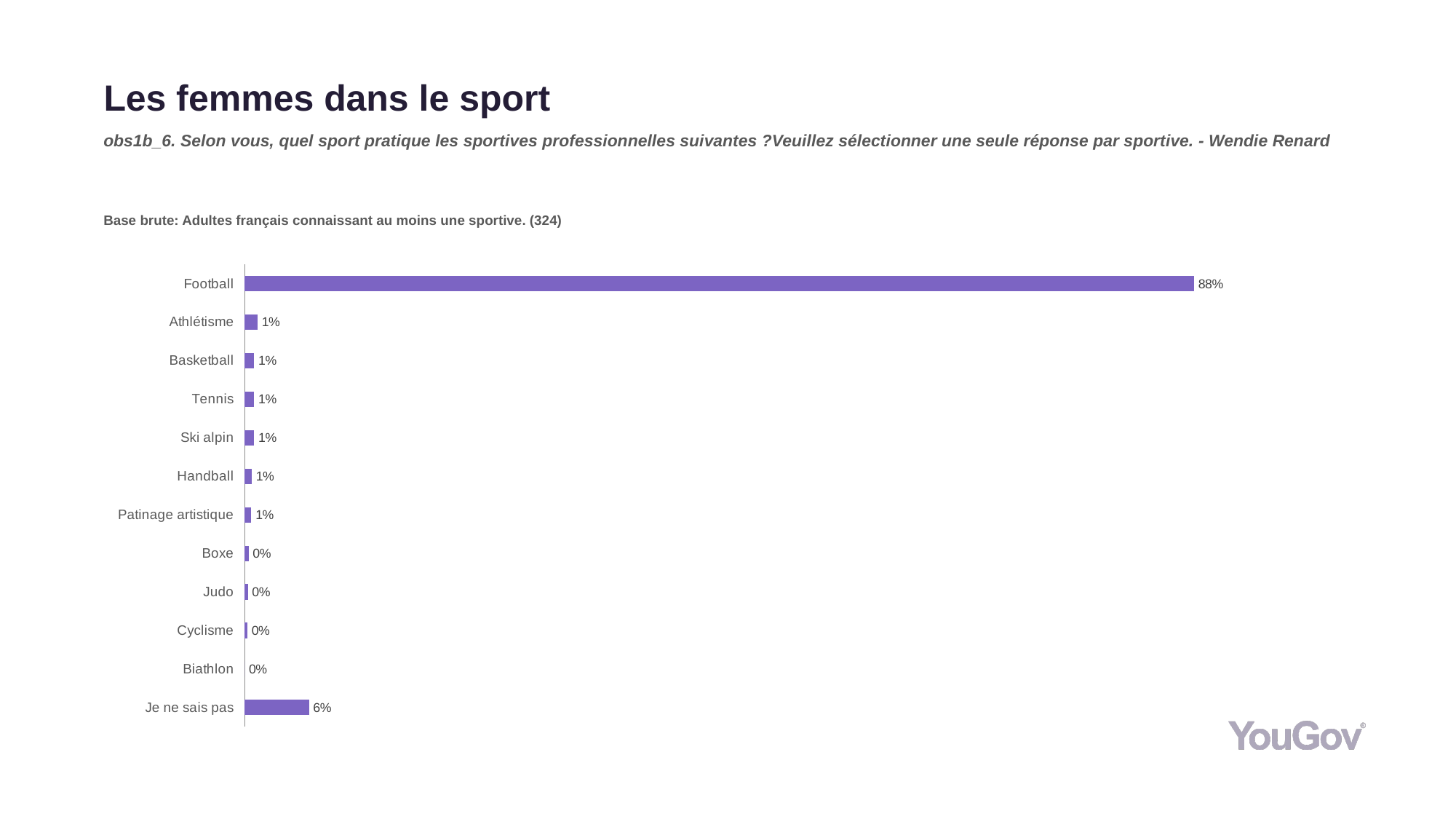
How many categories are shown on the chart? 12 What is the value for Je ne sais pas? 6% What is the difference between the values for Football and Je ne sais pas? 82% Which category has the highest value? Football What is the value for Handball? 1% Which is larger, the value for Je ne sais pas or the value for Tennis? Je ne sais pas What is the value for Football? 88% What is the difference between the values for Football and Basketball? 87% What is the value for Biathlon? 0% What is the value for Athlétisme? 1% What kind of chart is shown on the slide? Bar chart What is the title of the slide? Les femmes dans le sport